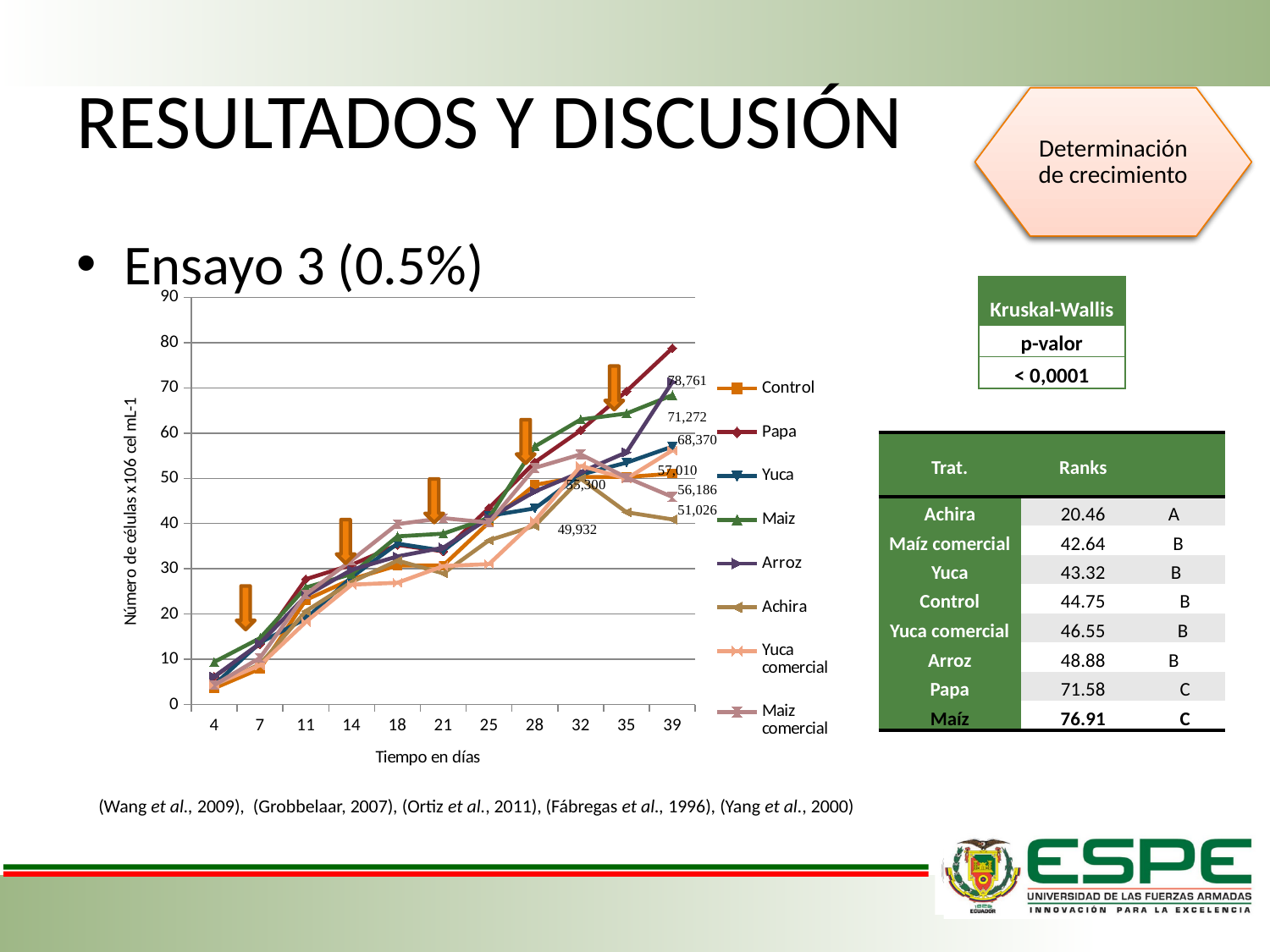
Do the series values generally rise or fall from day 4 to day 39? rise Is the value for Control at day 4 greater or less than 10? less Is the value for Papa at day 39 greater or less than 70? greater How many time points are shown on the x axis of the chart? 11 Which series has the lowest value at day 39? Achira At day 39, which is larger, Papa or Achira? Papa Which series has the highest value at day 39? Papa At day 39, which is larger, Maiz or Control? Maiz Is the value for Achira at day 39 greater or less than 50? less What is the title of the x axis of the chart? Tiempo en días How many series does the chart legend list? 8 What kind of chart is shown on the slide? line chart